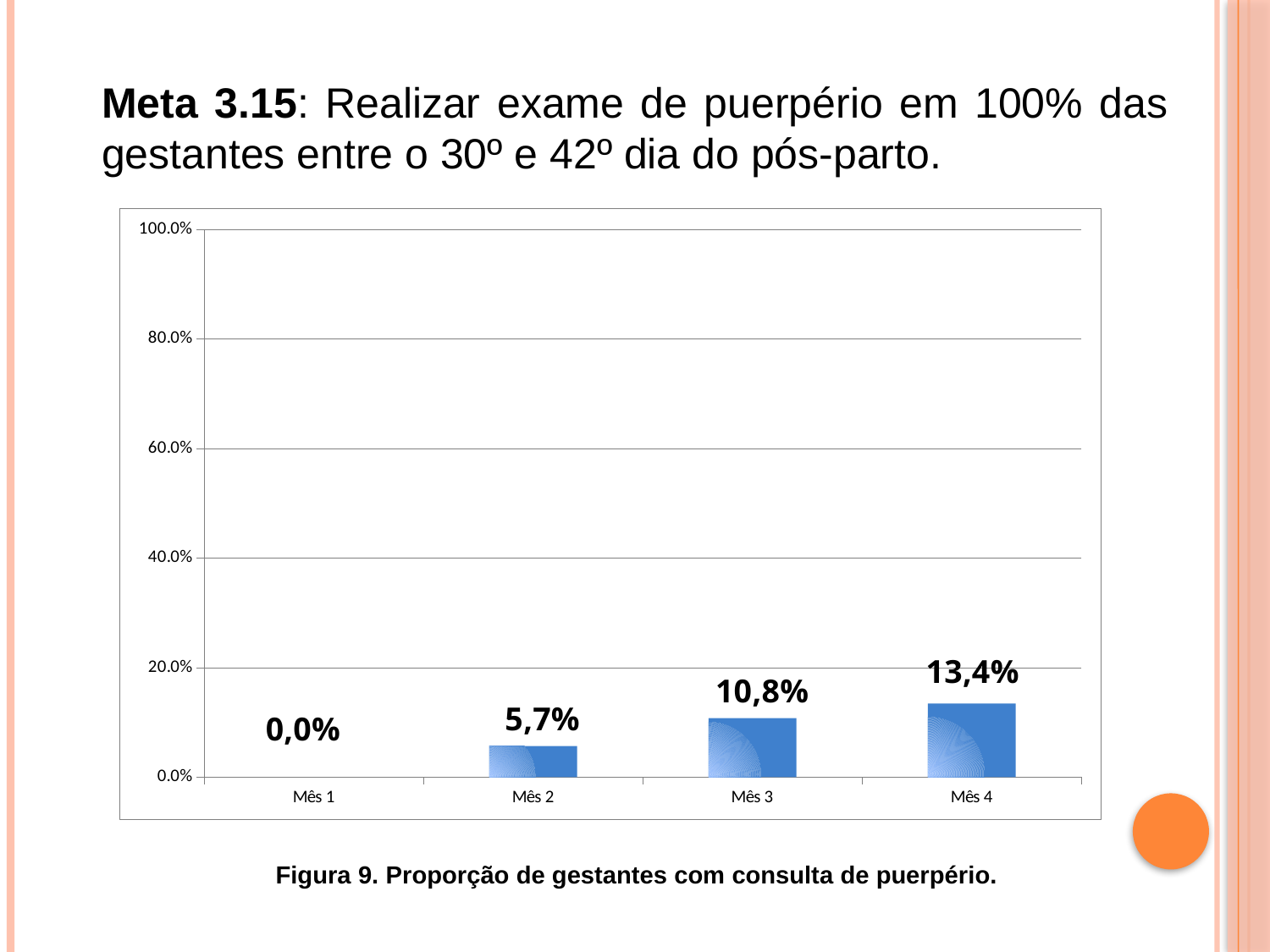
What is the difference between the values for Mês 4 and Mês 3? 2,6% What is the value for Mês 1? 0,0% Which month has the highest value? Mês 4 What is the value for Mês 4? 13,4% Which is larger, the value for Mês 2 or the value for Mês 3? Mês 3 What is the difference between the values for Mês 3 and Mês 2? 5,1% What is the value for Mês 2? 5,7% Which month has the lowest value? Mês 1 What kind of chart is shown? bar chart Is the value for Mês 4 greater or less than 20.0%? less How many months are shown on the x axis? 4 Do the values rise or fall from Mês 1 to Mês 4? rise